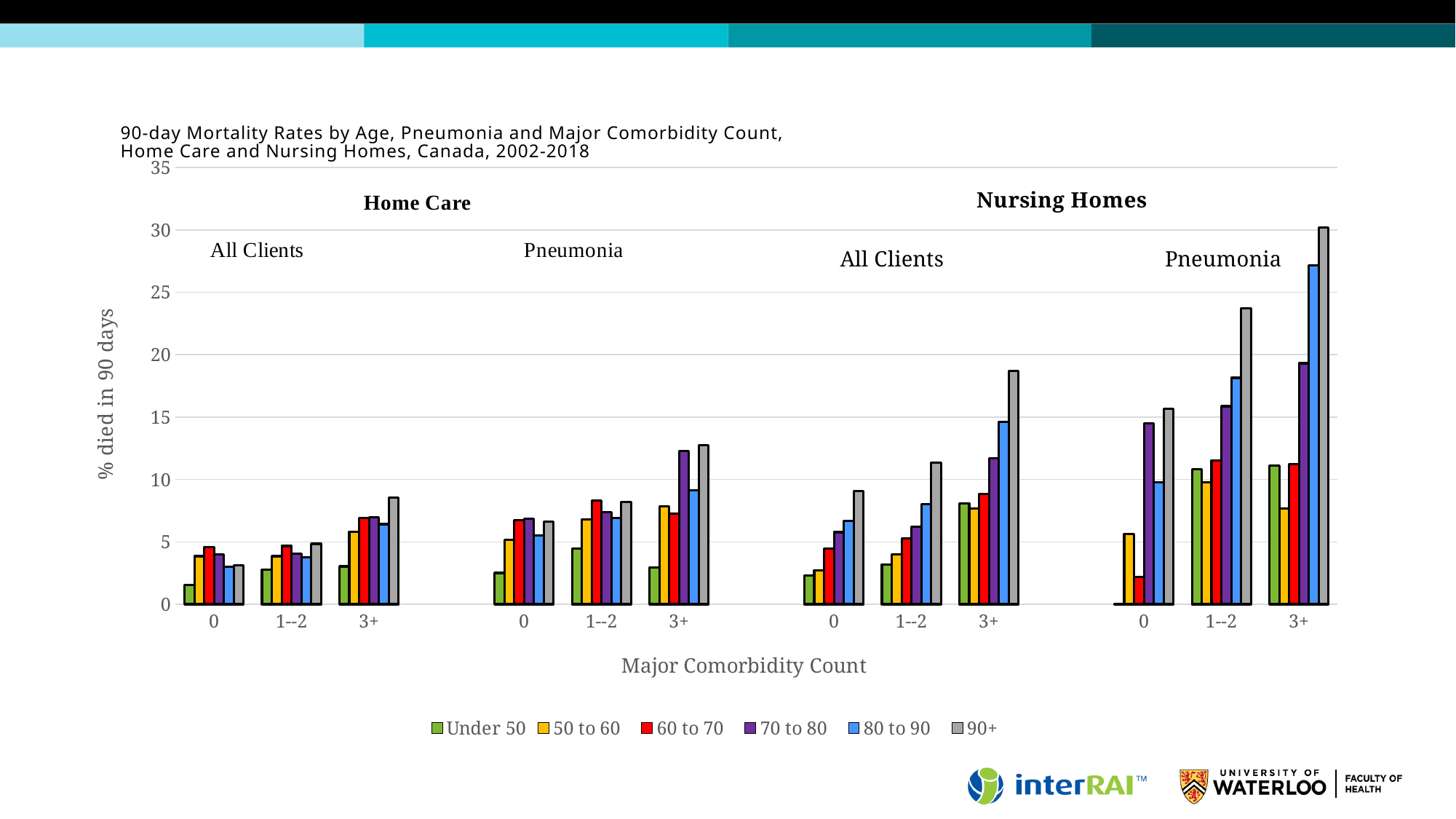
How many series does the legend list? 6 Is the value for the 90+ group in the Nursing Homes Pneumonia 1--2 category greater or less than 20? greater What kind of chart is shown on the slide? bar chart What is the label on the y axis? % died in 90 days Is the value for the 90+ group in the Nursing Homes All Clients 3+ category greater or less than 15? greater Is the value for the 90+ group in the Nursing Homes Pneumonia 3+ category greater or less than 25? greater Which age group has the highest bar anywhere on the chart? 90+ Which is larger: the 90+ bar for Pneumonia 3+ in Nursing Homes or the 90+ bar for Pneumonia 3+ in Home Care? Nursing Homes In the Nursing Homes All Clients panel, do the 90+ bars rise or fall as the major comorbidity count increases from 0 to 3+? rise In which panel and comorbidity category does the tallest bar on the chart appear? Nursing Homes, Pneumonia, 3+ How many comorbidity count categories are shown on the x axis within each panel? 3